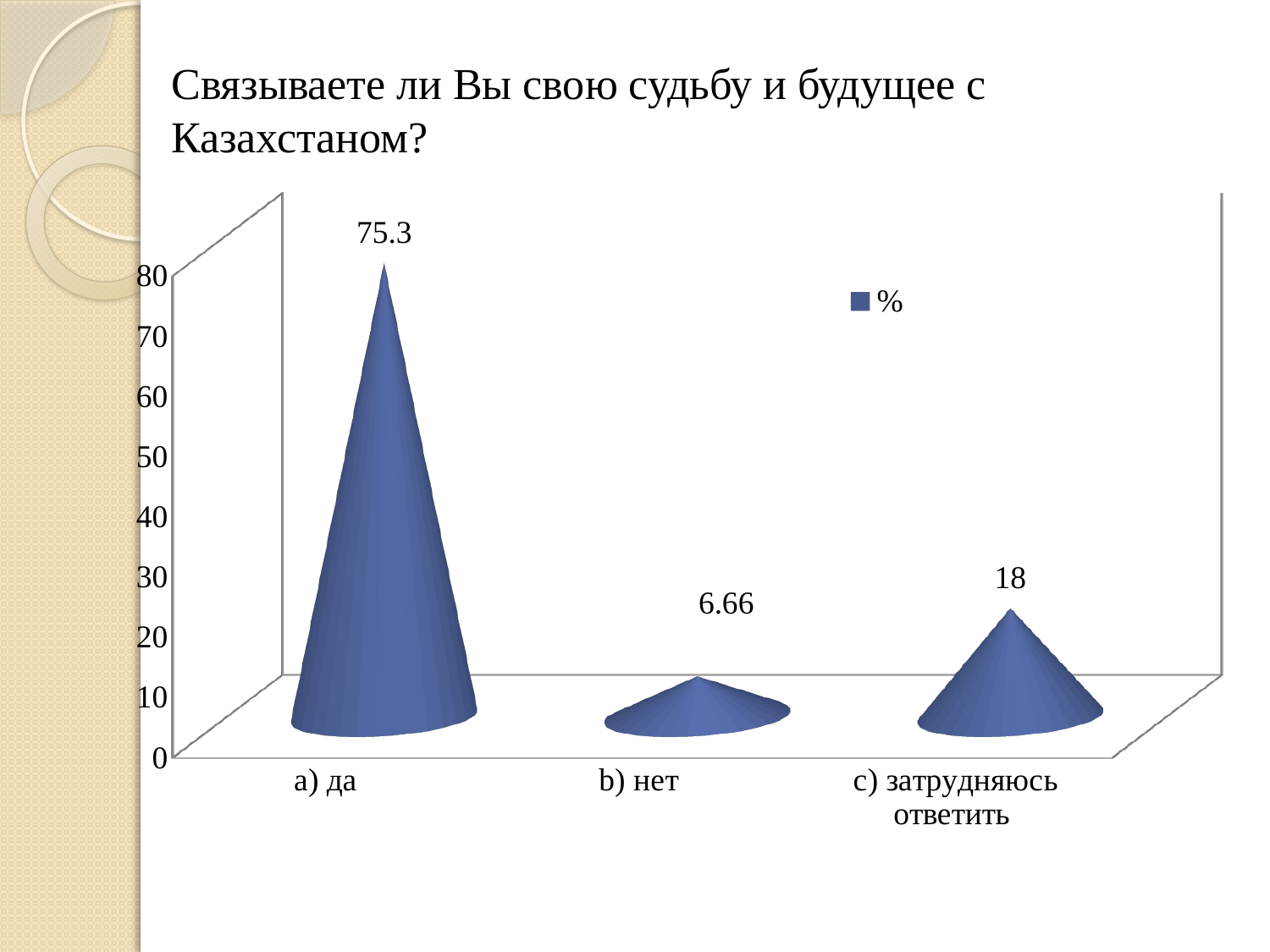
What is the difference between the values for "a) да" and "c) затрудняюсь ответить"? 57.3 Is the value for "a) да" greater or less than 70? greater Which category has the highest value? a) да What is the value for "b) нет"? 6.66 Which is larger, the value for "b) нет" or the value for "c) затрудняюсь ответить"? c) затрудняюсь ответить What is the difference between the values for "c) затрудняюсь ответить" and "b) нет"? 11.34 What is the value for "a) да"? 75.3 Which category has the lowest value? b) нет How many series does the legend list? 1 How many categories are shown on the chart? 3 What is the name of the series shown in the legend? % What is the value for "c) затрудняюсь ответить"? 18